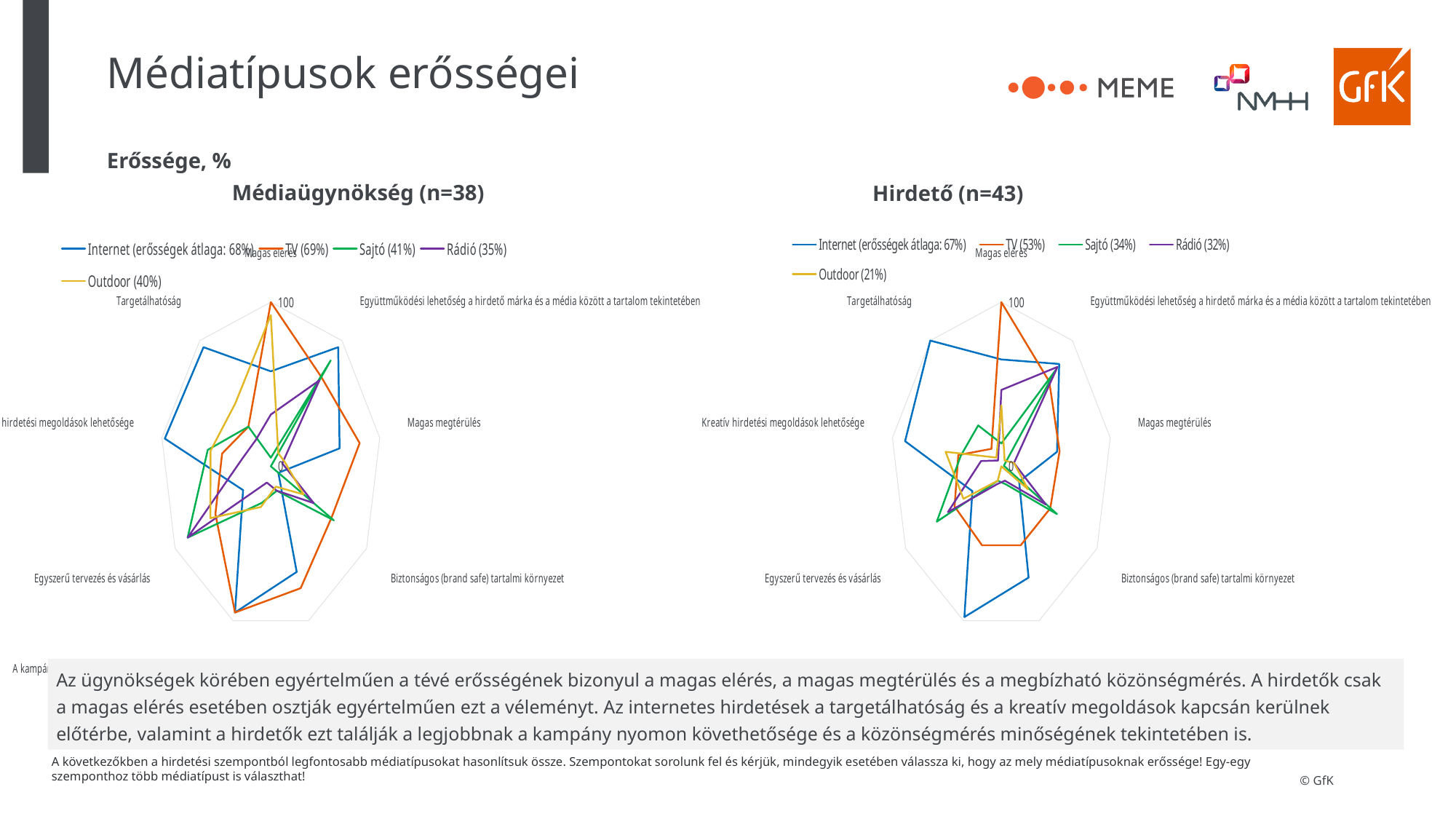
In the Hirdető (n=43) chart legend, which media type has the highest average strength? Internet (67%) In the Médiaügynökség (n=38) chart legend, what is the average strength given for TV? 69% In the Hirdető (n=43) chart, is the value for Outdoor at Magas megtérülés greater or less than 50? less How many axes (criteria) does the Médiaügynökség (n=38) radar chart have? 9 How many series does the legend of the Hirdető (n=43) chart list? 5 What kind of chart is used on the Médiaügynökség (n=38) slide panel? Radar chart In the Hirdető (n=43) chart legend, what is the average strength given for Outdoor? 21% In the Médiaügynökség (n=38) chart legend, what is the average strength given for Internet? 68% In the Hirdető (n=43) chart legend, what is the difference between the average strength of Internet and TV? 14 percentage points In the Médiaügynökség (n=38) chart, is the value for TV at Magas elérés greater or less than 50? greater In the Médiaügynökség (n=38) chart legend, which media type has the lowest average strength? Rádió (35%) In the Hirdető (n=43) chart, which is larger at Biztonságos (brand safe) tartalmi környezet: Internet or Outdoor? Outdoor